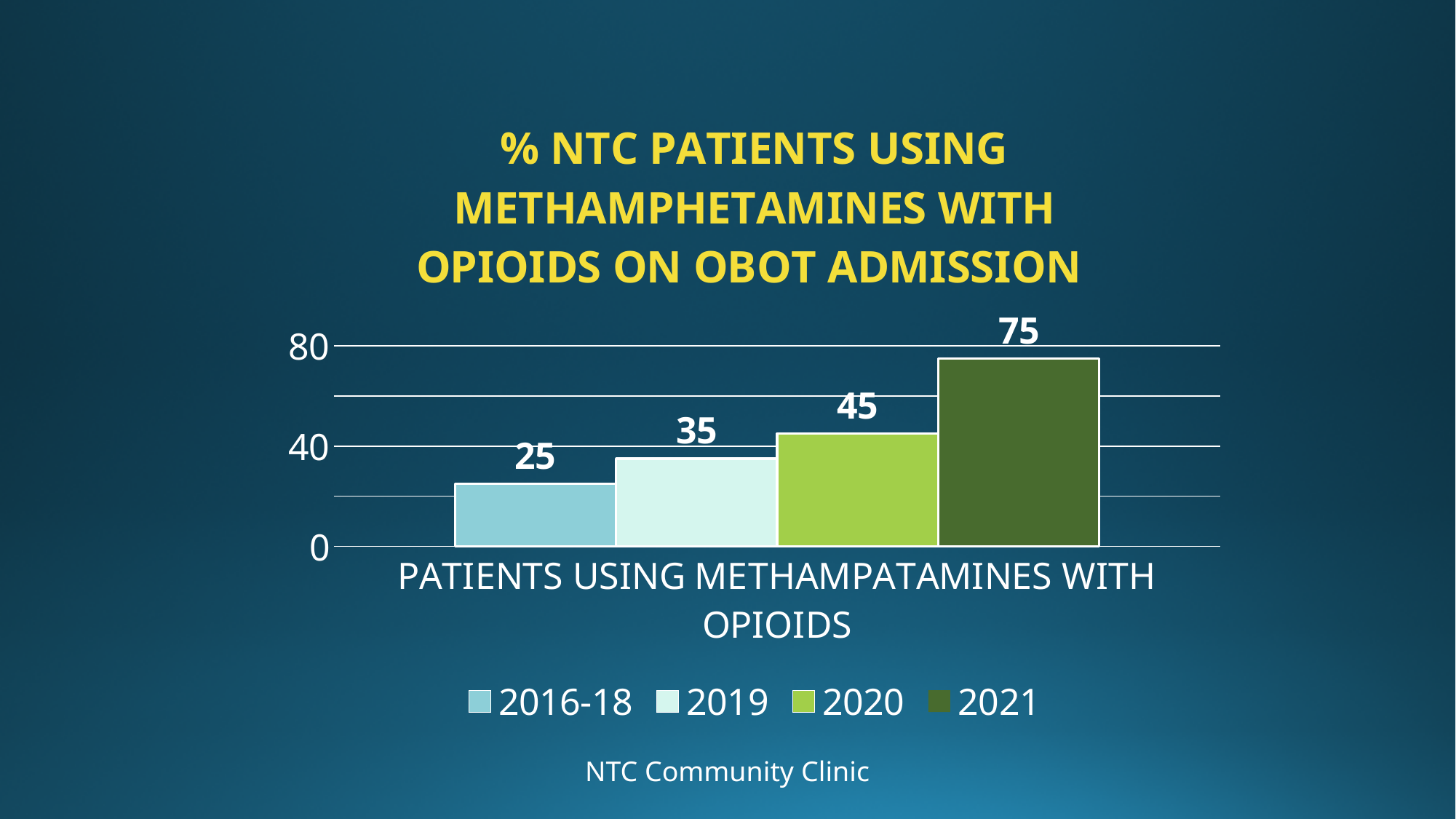
What is the value for 2019? 35 Which series has the highest value? 2021 How many series does the legend list? 4 Do the values rise or fall from 2016-18 to 2021? Rise What kind of chart is shown on the slide? Bar chart What is the value for 2021? 75 What is the value for 2020? 45 What is the value for 2016-18? 25 What is the difference between the values for 2021 and 2020? 30 Which series has the lowest value? 2016-18 Which is larger, the value for 2020 or the value for 2019? 2020 What is the difference between the values for 2019 and 2016-18? 10